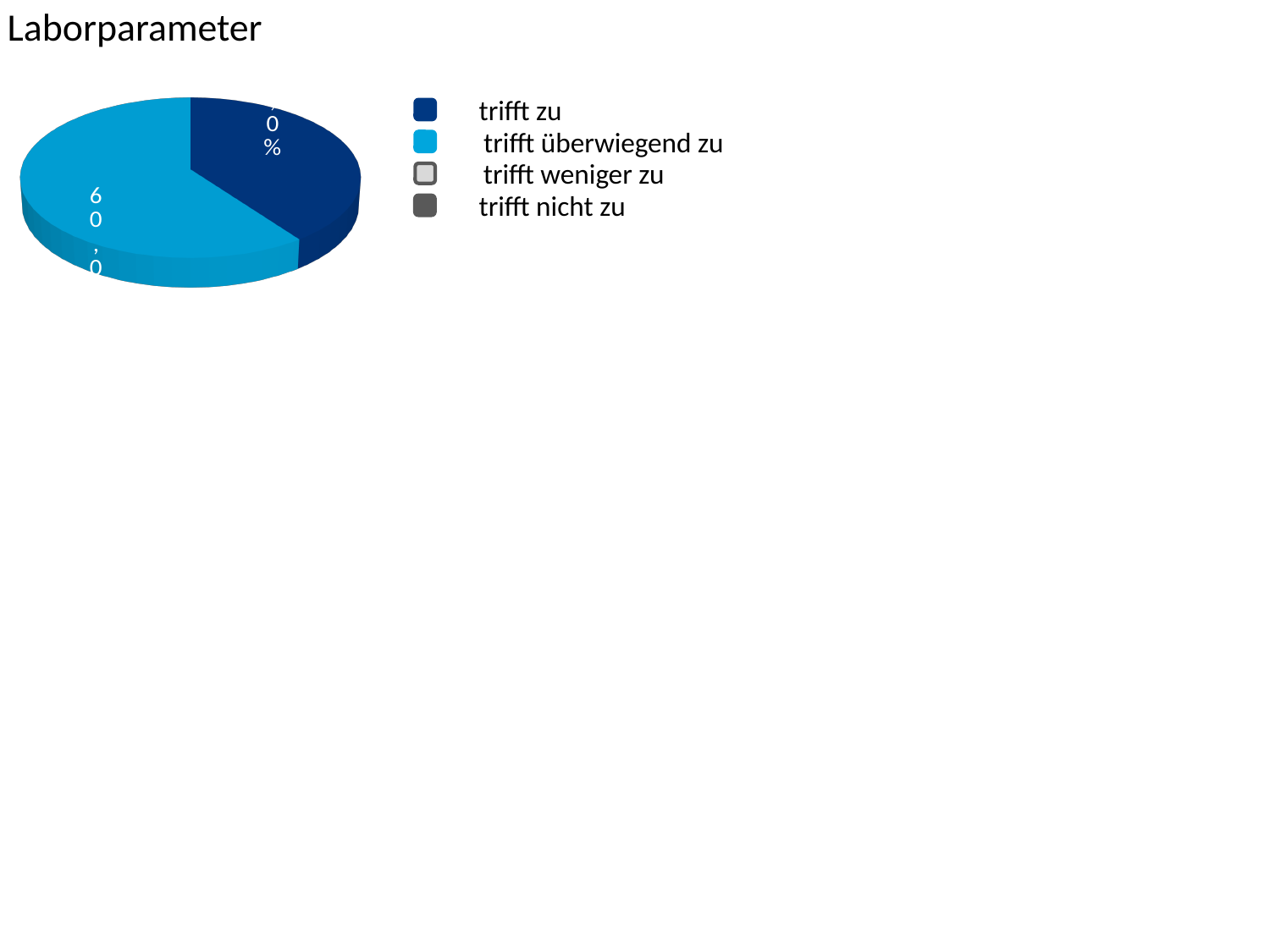
Is the slice for trifft überwiegend zu greater or less than half of the pie? greater Which legend entry is shown in dark blue? trifft zu What is the title of the chart on the slide? Laborparameter How many slices are visible in the pie chart? 2 How many entries does the legend of the pie chart list? 4 Which category has the largest slice in the pie chart? trifft überwiegend zu What kind of chart is shown on the slide? pie chart Which category has the larger slice in the pie chart, trifft zu or trifft überwiegend zu? trifft überwiegend zu Is the slice for trifft zu greater or less than half of the pie? less